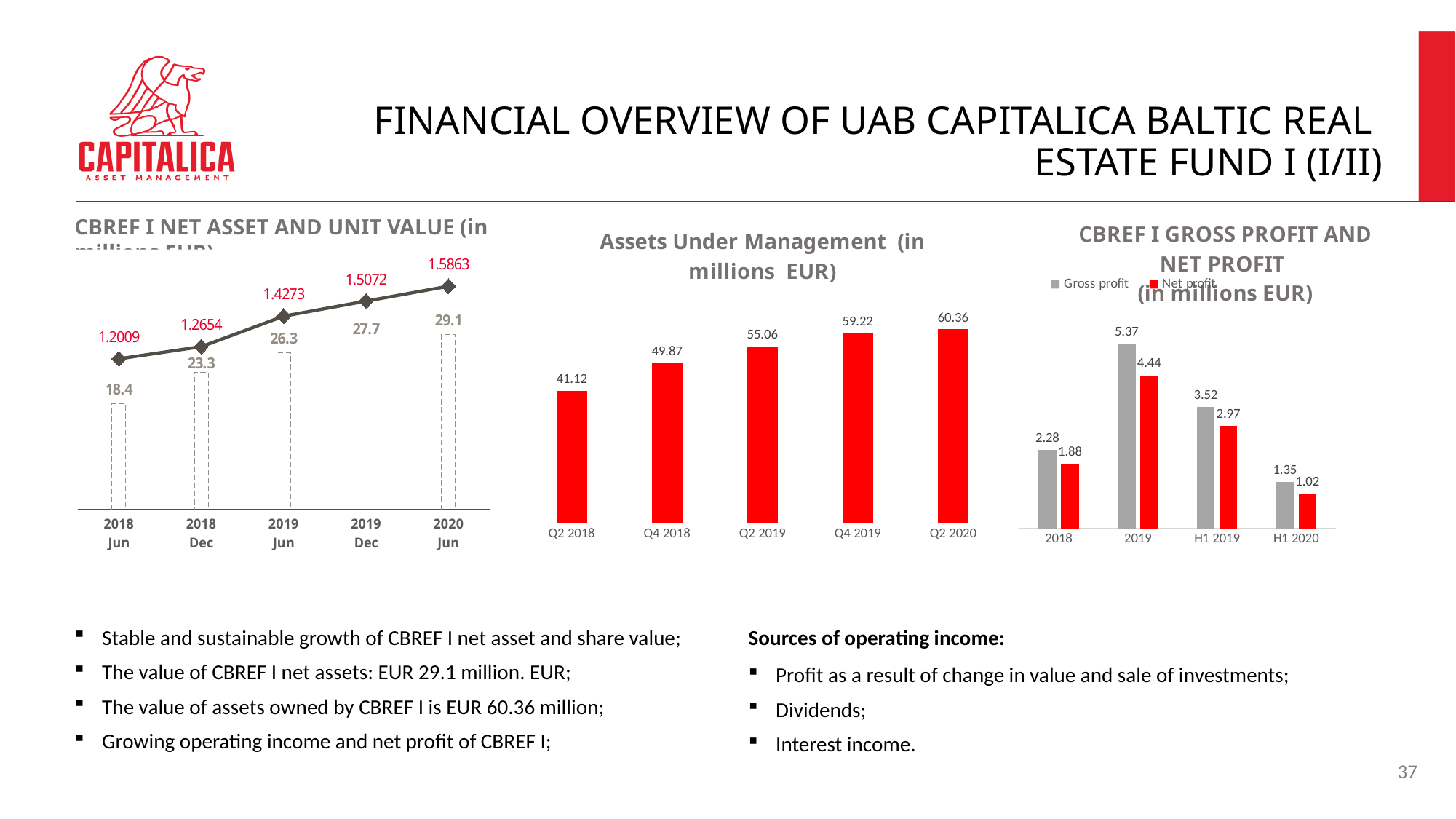
What kind of chart is the Assets Under Management chart? bar chart In the CBREF I Gross Profit and Net Profit chart, how many series does the legend list? 2 In the CBREF I Net Asset and Unit Value chart, what is the net asset value for 2018 Dec? 23.3 In the Assets Under Management chart, what is the value for Q2 2019? 55.06 In the Assets Under Management chart, which period has the highest value? Q2 2020 In the CBREF I Gross Profit and Net Profit chart, which period has the lowest gross profit? H1 2020 In the CBREF I Gross Profit and Net Profit chart, what is the difference between gross profit and net profit for H1 2019? 0.55 In the CBREF I Gross Profit and Net Profit chart, what is the net profit for 2019? 4.44 In the Assets Under Management chart, do the values rise or fall from Q2 2018 to Q2 2020? rise In the Assets Under Management chart, how many periods are plotted? 5 In the CBREF I Net Asset and Unit Value chart, what is the unit value for 2020 Jun? 1.5863 In the Assets Under Management chart, what is the difference between the Q2 2020 and Q2 2018 values? 19.24